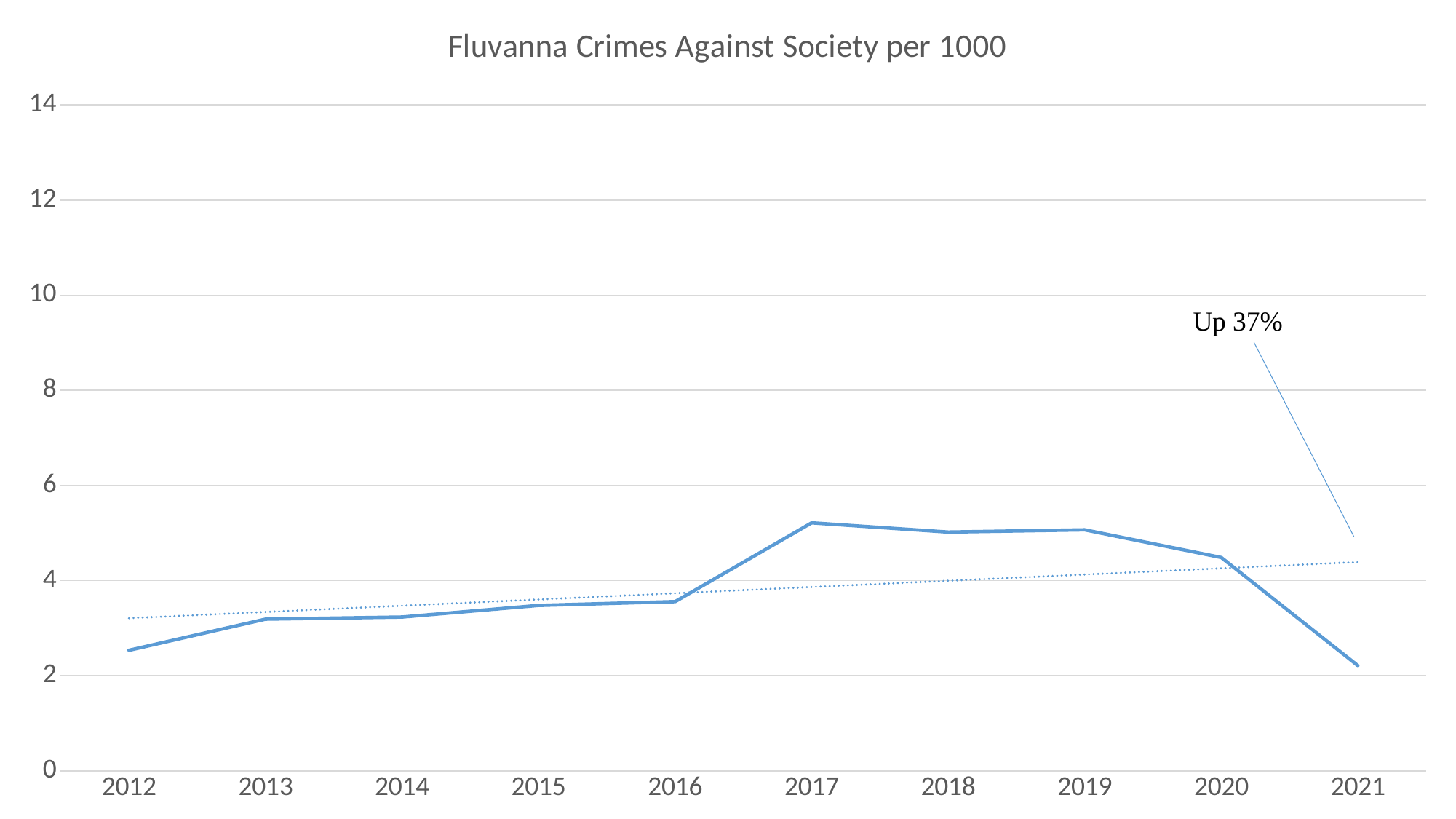
Is the value for 2012 greater or less than 4? less Do the values rise or fall from 2019 to 2021? fall Is the value for 2019 greater or less than 4? greater What text annotation is shown near the dotted trendline on the right of the chart? Up 37% Is the value for 2021 greater or less than 4? less What kind of chart is shown on the slide? line chart Which year has the highest value? 2017 What is the title of the chart? Fluvanna Crimes Against Society per 1000 Which year has the larger value, 2012 or 2017? 2017 How many years are plotted along the x axis? 10 Which year has the lowest value? 2021